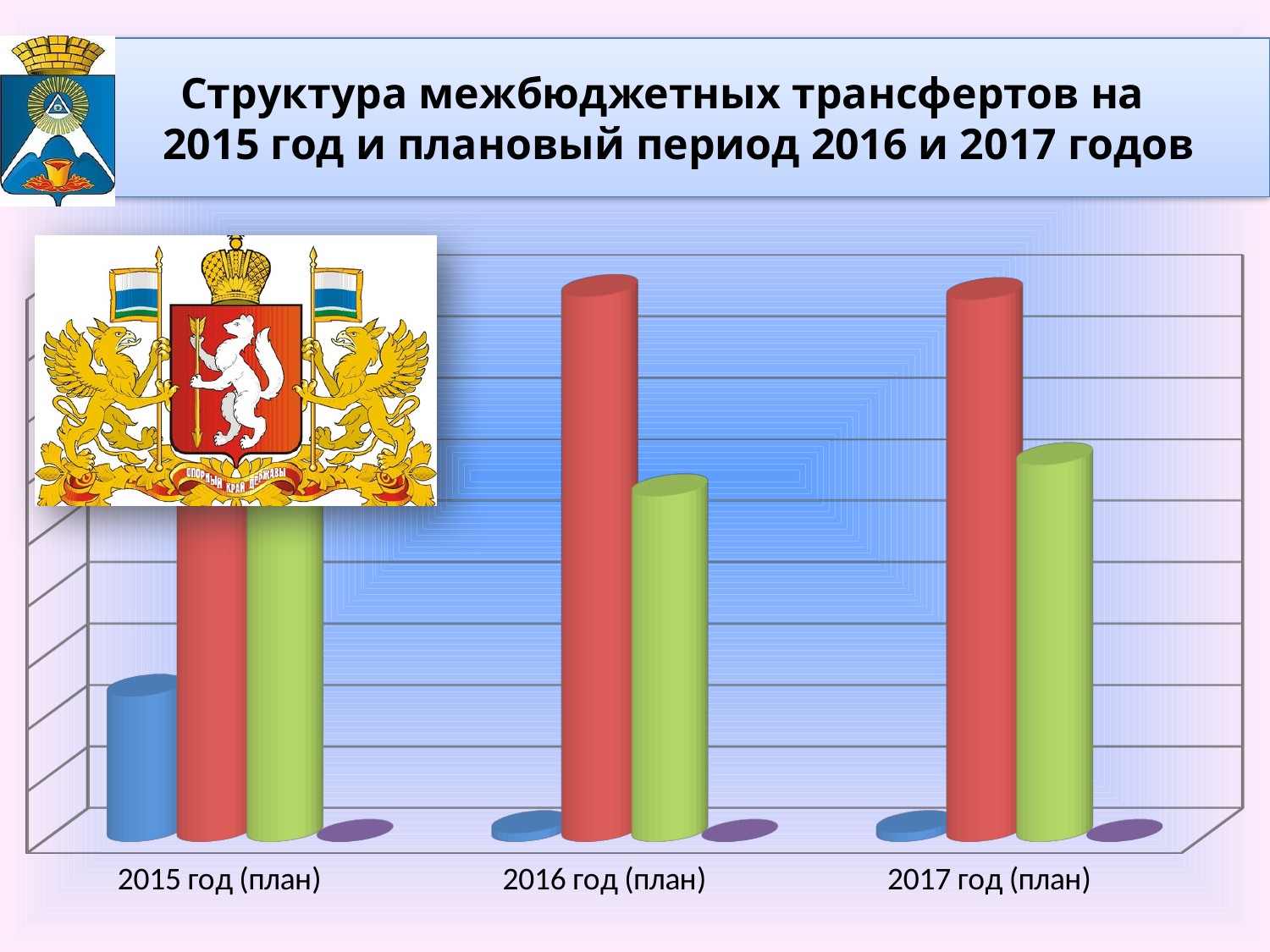
Is the green bar taller for 2016 год (план) or for 2017 год (план)? 2017 год (план) In the 2017 год (план) group, which bar is taller, the red one or the green one? the red one Which colour bar is the tallest in the 2016 год (план) group? red For which year category is the blue bar the tallest? 2015 год (план) How many categories are shown on the x axis of the chart? 3 Which colour bar is the shortest in the 2017 год (план) group? purple How many bars are plotted for each year category in the chart? 4 Is the blue bar taller for 2015 год (план) or for 2016 год (план)? 2015 год (план) What is the title of the slide's chart? Структура межбюджетных трансфертов на 2015 год и плановый период 2016 и 2017 годов What kind of chart is shown on the slide? bar chart What is the label of the first category on the x axis? 2015 год (план)